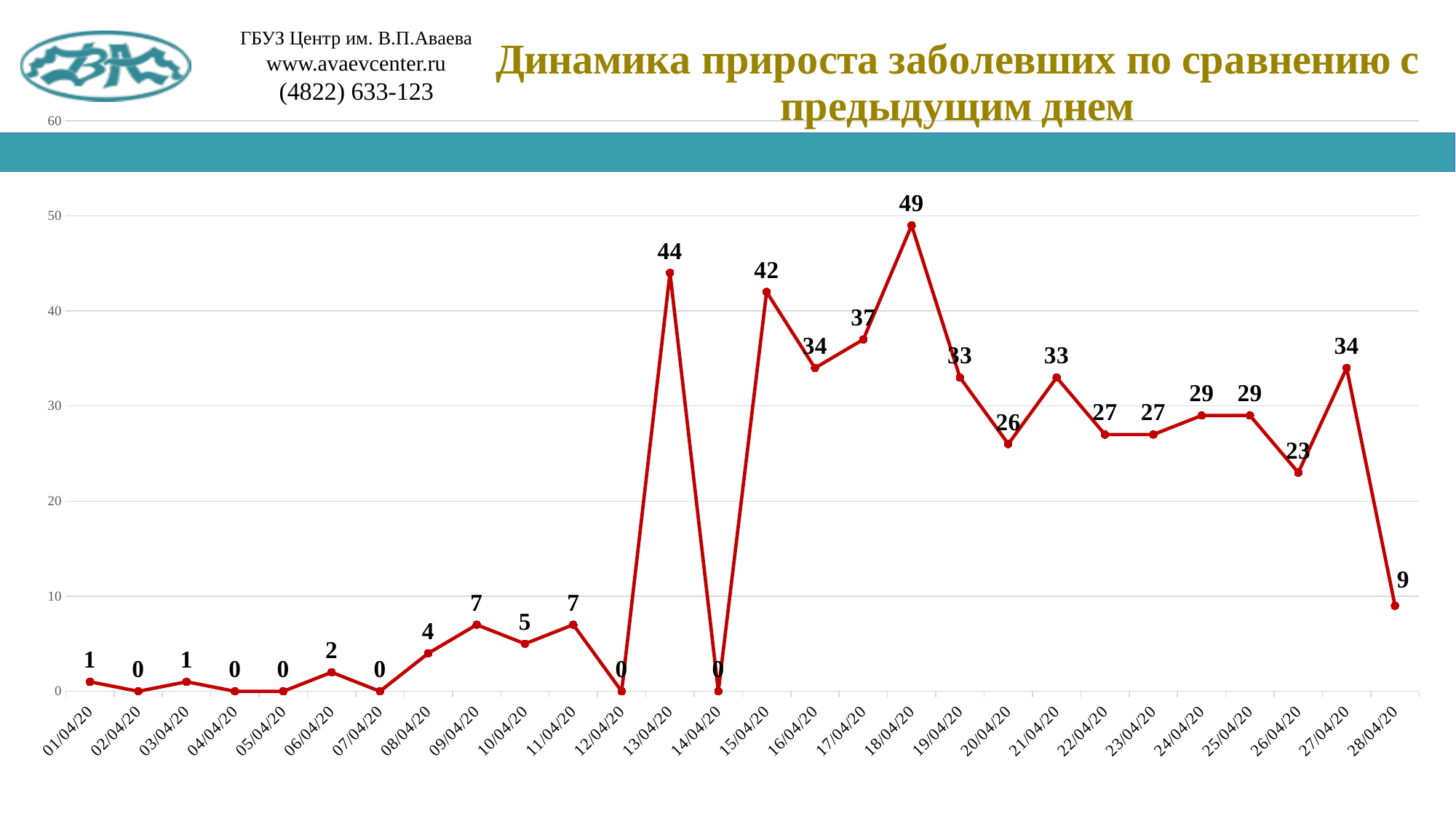
What is the value for 26/04/20? 23 Which is larger, the value for 15/04/20 or the value for 16/04/20? 15/04/20 What is the difference between the values for 18/04/20 and 19/04/20? 16 What is the value for 13/04/20? 44 What is the title of the chart? Динамика прироста заболевших по сравнению с предыдущим днем What is the highest value plotted on the chart? 49 What type of chart is shown on the slide? line chart On which date is the value highest? 18/04/20 Is the value for 27/04/20 greater or less than 30? greater What is the value for 28/04/20? 9 How many dates are plotted on the x axis? 28 What is the lowest value plotted on the chart? 0